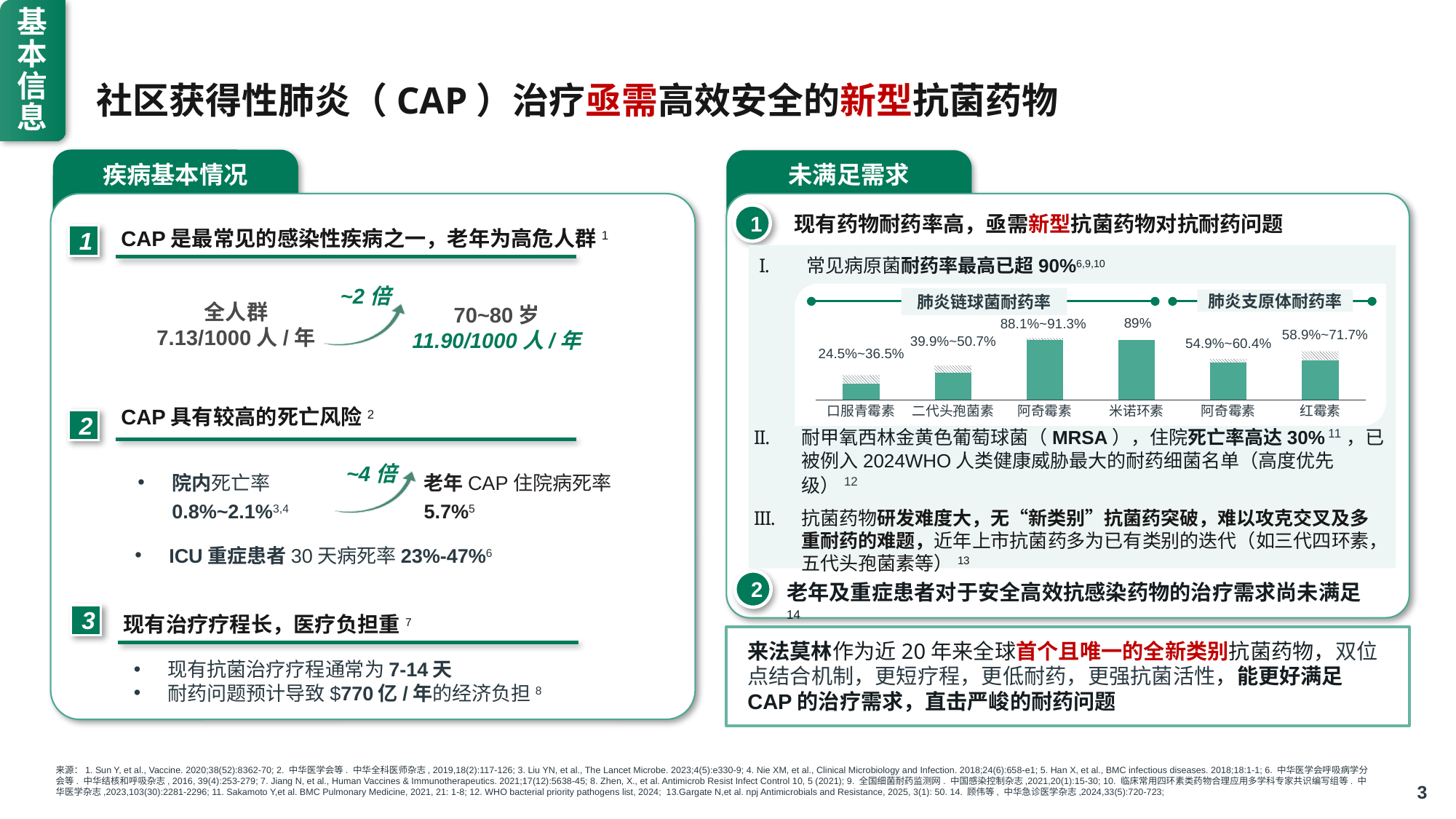
What is the resistance rate shown for 阿奇霉素 under 肺炎链球菌耐药率? 88.1%~91.3% What is the resistance rate shown for 二代头孢菌素 in the chart? 39.9%~50.7% Which has a higher resistance rate in the chart, 口服青霉素 or 二代头孢菌素? 二代头孢菌素 How many antibiotics (bars) are shown in the resistance rate chart? 6 What are the two group headings shown above the bars in the resistance rate chart? 肺炎链球菌耐药率 and 肺炎支原体耐药率 What is the resistance rate shown for 阿奇霉素 under 肺炎支原体耐药率? 54.9%~60.4% Which antibiotic has the lowest resistance rate in the chart? 口服青霉素 What is the resistance rate shown for 米诺环素 in the chart? 89% What is the resistance rate shown for 口服青霉素 in the chart? 24.5%~36.5% What kind of chart is shown under 常见病原菌耐药率最高已超 90%? bar chart How many antibiotics are grouped under 肺炎链球菌耐药率 in the chart? 4 What is the resistance rate shown for 红霉素 in the chart? 58.9%~71.7%